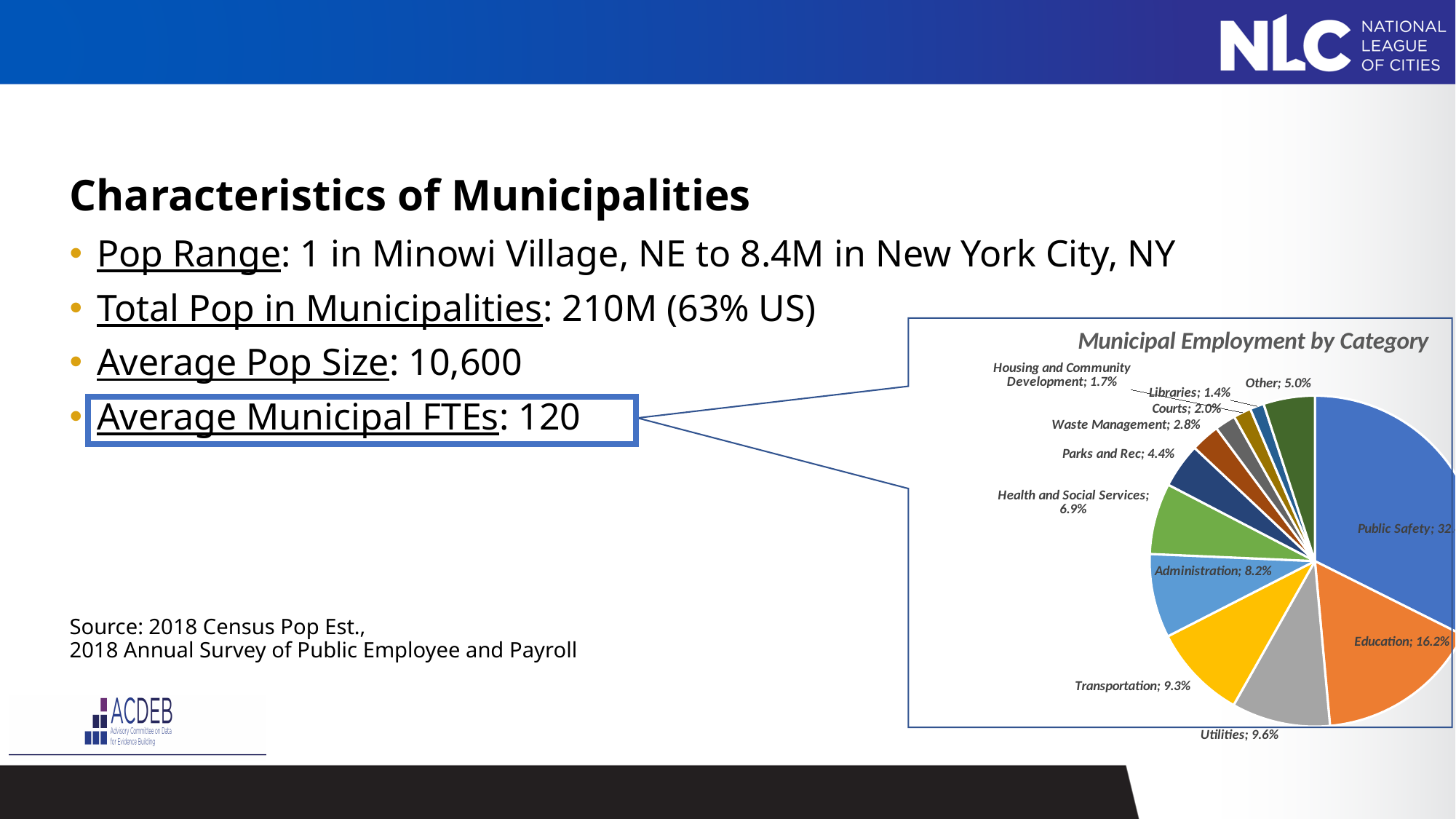
Which category has the largest share of municipal employment? Public Safety What kind of chart is shown on the slide? pie chart How many categories are shown in the pie chart? 12 What share of municipal employment is Libraries? 1.4% What share of municipal employment is Health and Social Services? 6.9% What share of municipal employment is Administration? 8.2% What share of municipal employment is Education? 16.2% What is the title of the chart on the slide? Municipal Employment by Category What is the difference between the Education share and the Utilities share? 6.6% What share of municipal employment is Transportation? 9.3% What share of municipal employment is Utilities? 9.6% Which category has the smallest share of municipal employment? Libraries